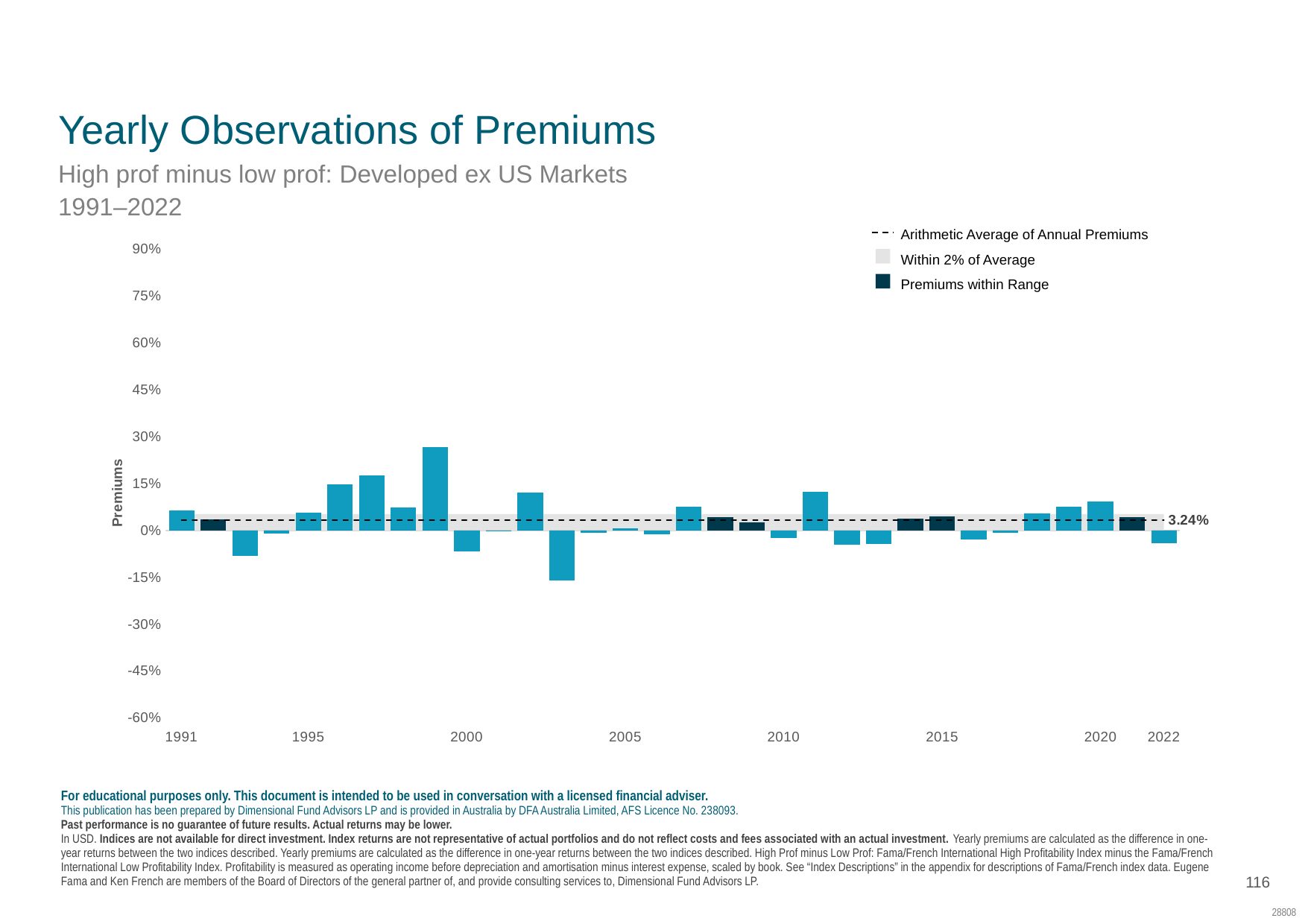
What is the arithmetic average of annual premiums shown on the chart? 3.24% Which year has the highest premium on the chart? 1999 Is the premium for 2011 greater or less than 0%? greater How many years of premiums are plotted on the chart? 32 Which year has the lowest premium on the chart? 2003 What kind of chart is shown on the slide? Bar chart Is the premium for 1999 greater or less than 15%? greater What does the dashed line on the chart represent according to the legend? Arithmetic Average of Annual Premiums What is the label on the vertical axis of the chart? Premiums Which year has the larger premium, 1999 or 2003? 1999 Is the premium for 2003 greater or less than 0%? less How many entries does the chart legend list? 3